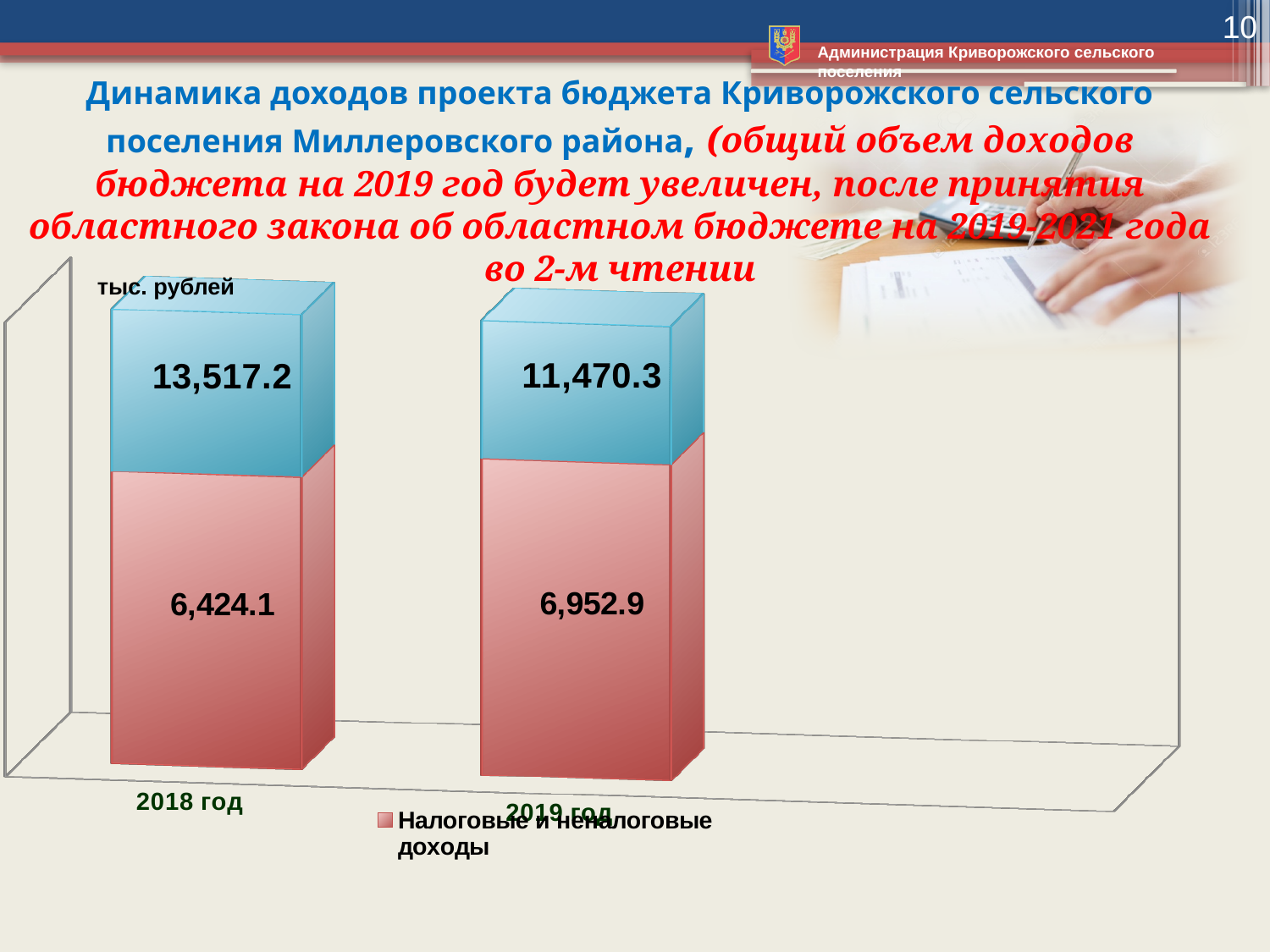
What is the value of the 'Налоговые и неналоговые доходы' segment for 2018 год? 6,424.1 What is the difference between the upper (blue) segment values for 2018 год and 2019 год? 2,046.9 What value is printed on the upper (blue) segment of the 2019 год bar? 11,470.3 What is the total of the stacked bar for 2018 год? 19,941.3 What value is printed on the upper (blue) segment of the 2018 год bar? 13,517.2 What is the total of the stacked bar for 2019 год? 18,423.2 By how much does the 'Налоговые и неналоговые доходы' value for 2019 год exceed that for 2018 год? 528.8 What kind of chart is shown on the slide? Stacked bar chart How many years (bars) are shown in the chart? 2 Which year has the larger upper (blue) segment value? 2018 год Which year has the larger 'Налоговые и неналоговые доходы' value, 2018 год or 2019 год? 2019 год What is the value of the 'Налоговые и неналоговые доходы' segment for 2019 год? 6,952.9